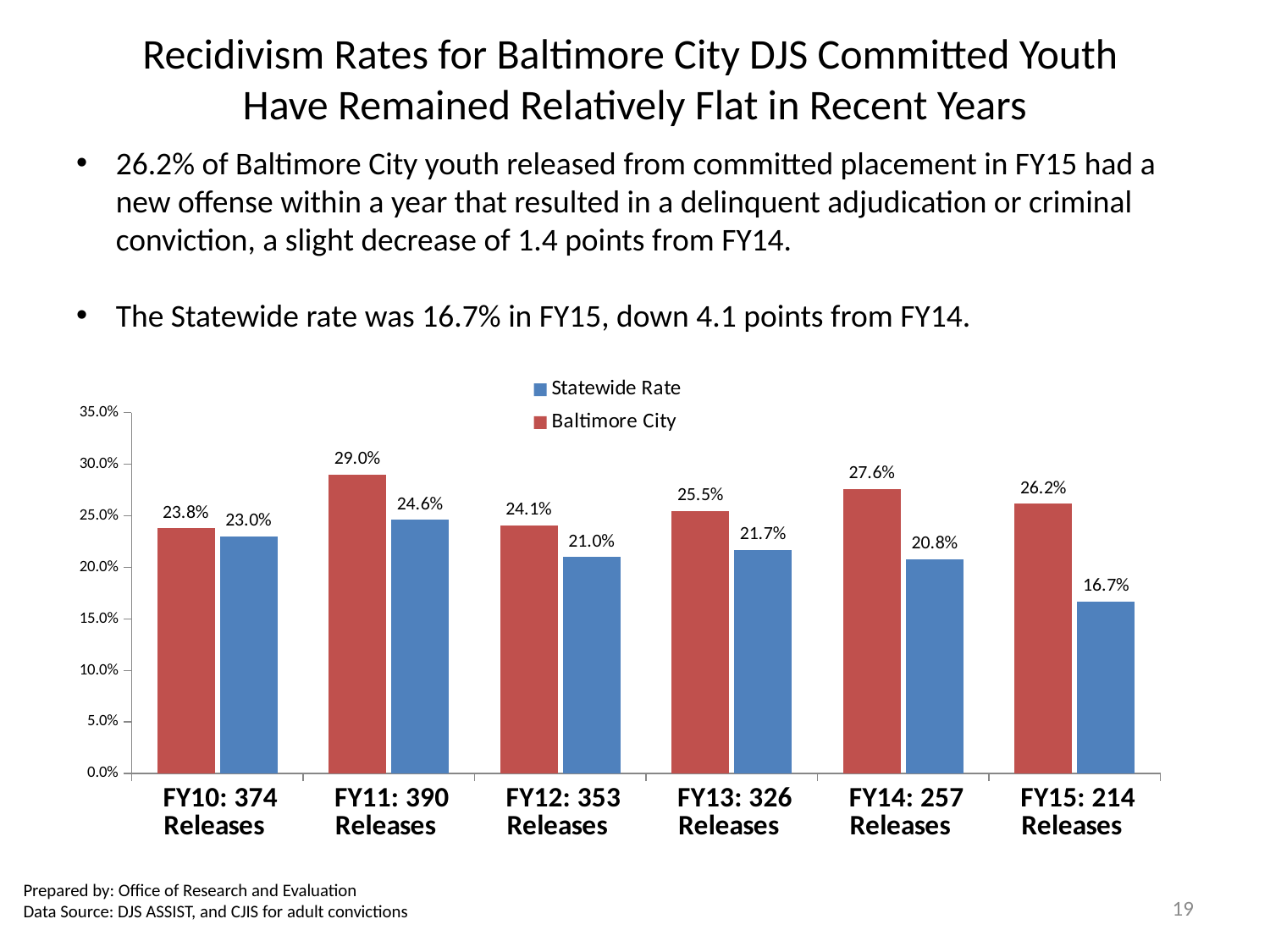
What colour are the Baltimore City bars? Red What is the Statewide Rate for FY12: 353 Releases? 21.0% What kind of chart is shown on the slide? Bar chart Which fiscal year has the lowest Statewide Rate? FY15: 214 Releases How many series does the legend list? 2 Does the Statewide Rate rise or fall from FY13: 326 Releases to FY15: 214 Releases? Fall How many fiscal years are shown on the x axis? 6 Which fiscal year has the highest Baltimore City rate? FY11: 390 Releases Is the Statewide Rate for FY13: 326 Releases greater or less than 20.0%? greater Which is larger for FY14: 257 Releases, the Baltimore City rate or the Statewide Rate? Baltimore City What is the Baltimore City recidivism rate for FY15: 214 Releases? 26.2% What is the difference between the Baltimore City rate and the Statewide Rate for FY15: 214 Releases? 9.5 percentage points